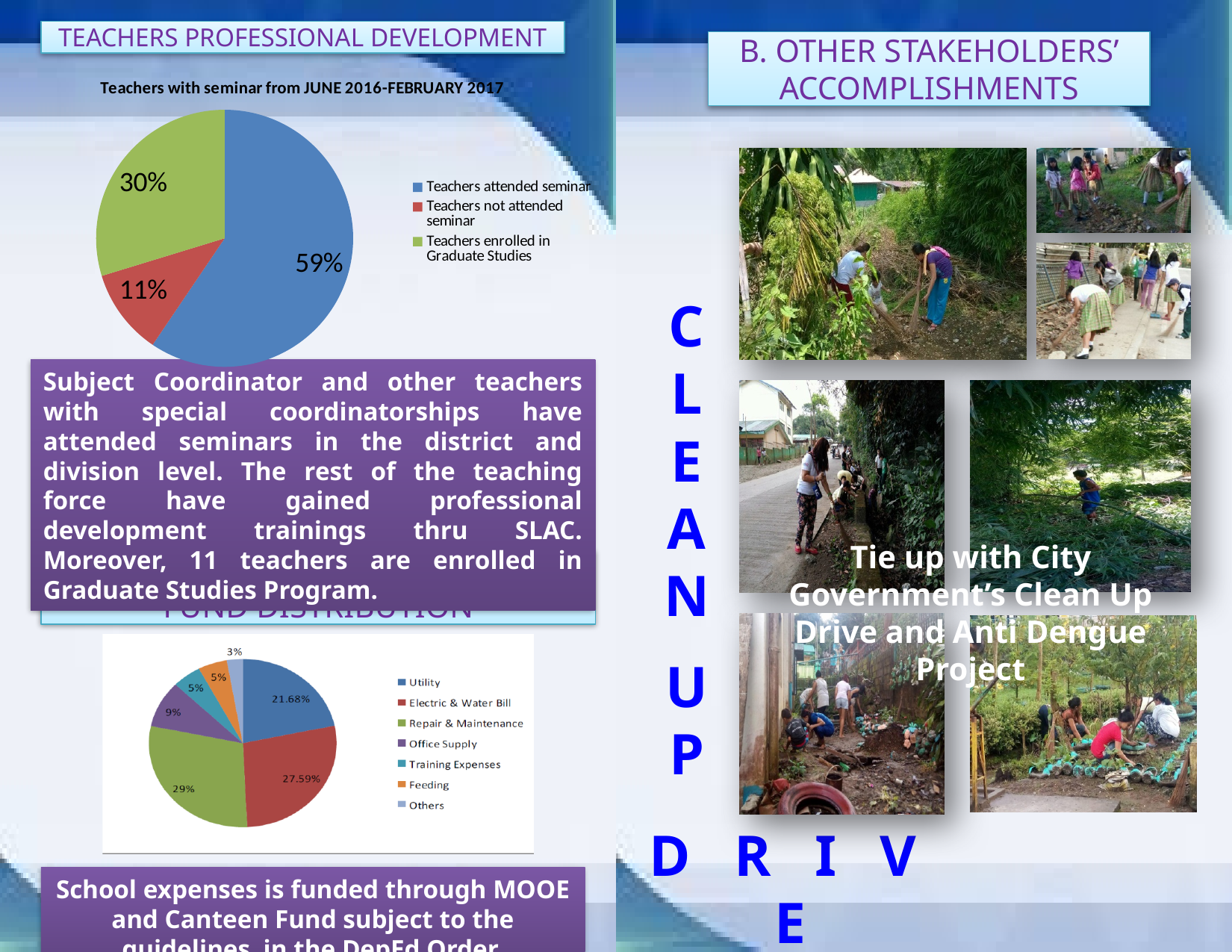
In the 'Teachers with seminar from JUNE 2016-FEBRUARY 2017' chart, what percentage of teachers attended seminar? 59% How many categories does the legend of the 'Teachers with seminar from JUNE 2016-FEBRUARY 2017' chart list? 3 In the 'FUND DISTRIBUTION' chart, which is larger: Office Supply or Training Expenses? Office Supply In the 'FUND DISTRIBUTION' chart, what is the share for Utility? 21.68% In the 'FUND DISTRIBUTION' chart, what is the share for Electric & Water Bill? 27.59% What type of chart is the 'Teachers with seminar from JUNE 2016-FEBRUARY 2017' chart? Pie chart How many categories does the legend of the 'FUND DISTRIBUTION' chart list? 7 In the 'FUND DISTRIBUTION' chart, which category has the smallest share? Others In the 'Teachers with seminar from JUNE 2016-FEBRUARY 2017' chart, what percentage of teachers are enrolled in Graduate Studies? 30% In the 'Teachers with seminar from JUNE 2016-FEBRUARY 2017' chart, which category has the smallest share? Teachers not attended seminar In the 'Teachers with seminar from JUNE 2016-FEBRUARY 2017' chart, what is the difference between the share of teachers who attended seminar and those who did not? 48% In the 'FUND DISTRIBUTION' chart, which category has the largest share? Repair & Maintenance